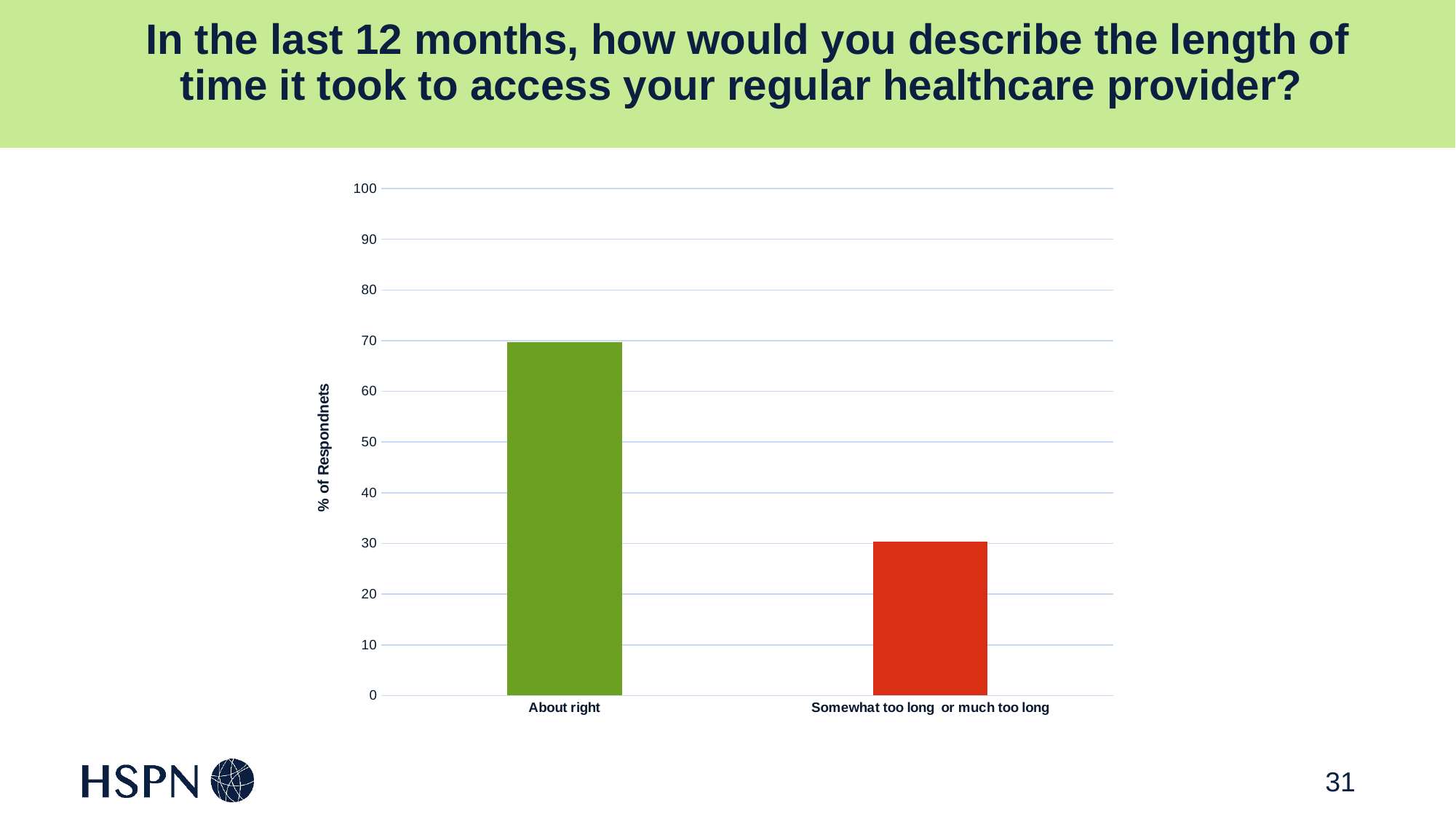
What is the highest value shown on the y axis of the chart? 100 Is the value for "About right" greater or less than 60? greater What kind of chart is shown on the slide? bar chart Which category has the lowest value in the chart? Somewhat too long or much too long Which is larger: the value for "About right" or the value for "Somewhat too long or much too long"? About right What is the label of the y axis of the chart? % of Respondnets Is the value for "Somewhat too long or much too long" greater or less than 20? greater Is the value for "About right" greater or less than 80? less How many categories are shown on the x axis of the chart? 2 Which category has the highest value in the chart? About right What colour is the bar for "About right"? green